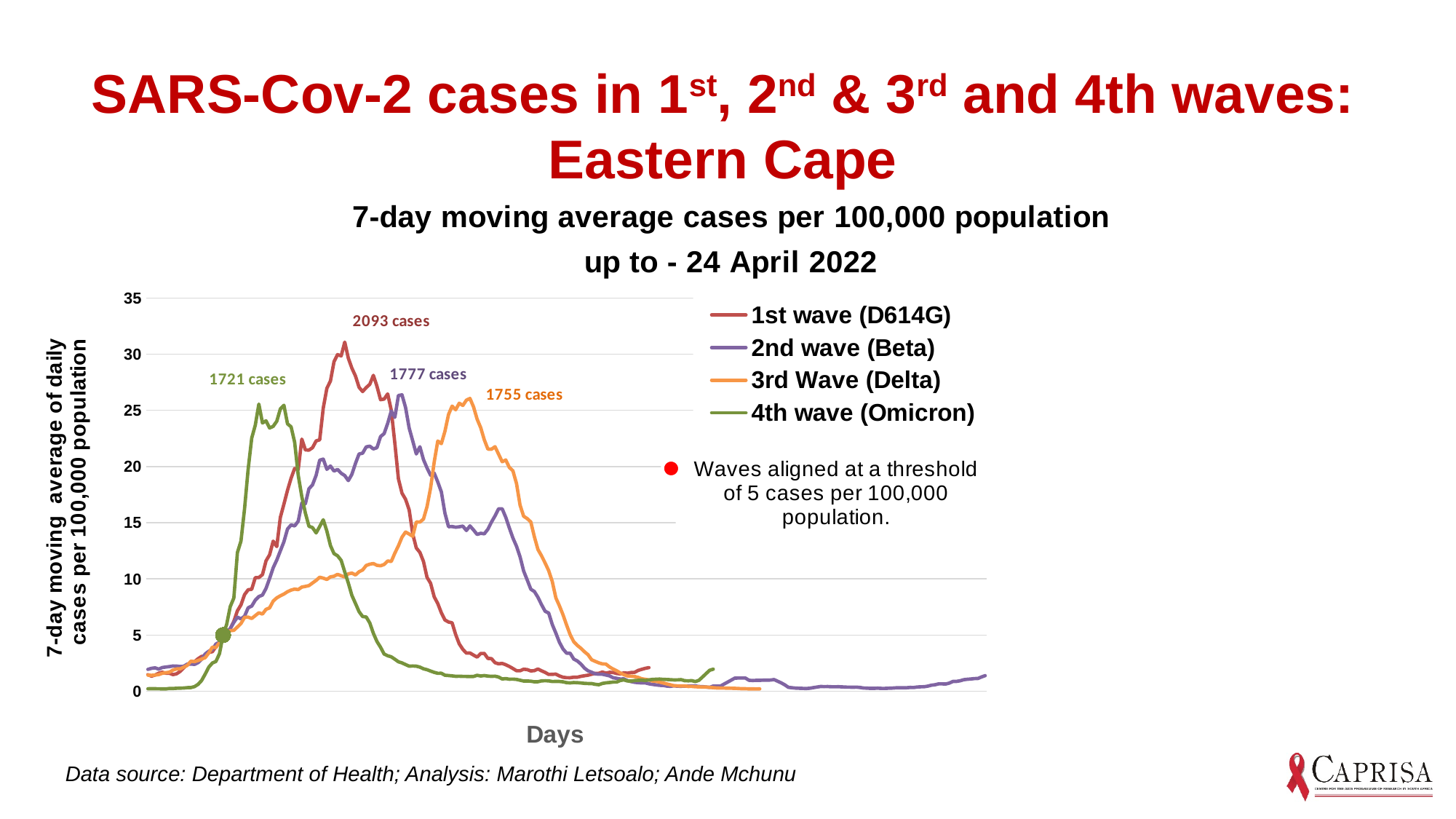
How many cases are annotated for the 4th wave (Omicron) peak? 1721 cases What is the difference between the annotated case counts for the 1st wave (2093 cases) and the 2nd wave (1777 cases)? 316 How many series does the legend list? 4 Is the peak of the 1st wave (D614G) line greater or less than 25 cases per 100,000 population? greater At what threshold of cases per 100,000 population are the waves aligned on the chart? 5 cases per 100,000 population What kind of chart is shown on the slide? line chart How many cases are annotated for the 1st wave (D614G) peak? 2093 cases Which has a higher peak on the chart, the 1st wave (D614G) or the 3rd Wave (Delta)? 1st wave (D614G) Is the peak of the 4th wave (Omicron) line greater or less than 30 cases per 100,000 population? less How many cases are annotated for the 3rd Wave (Delta) peak? 1755 cases How many cases are annotated for the 2nd wave (Beta) peak? 1777 cases Which wave reaches the highest peak in 7-day moving average cases per 100,000 population? 1st wave (D614G)